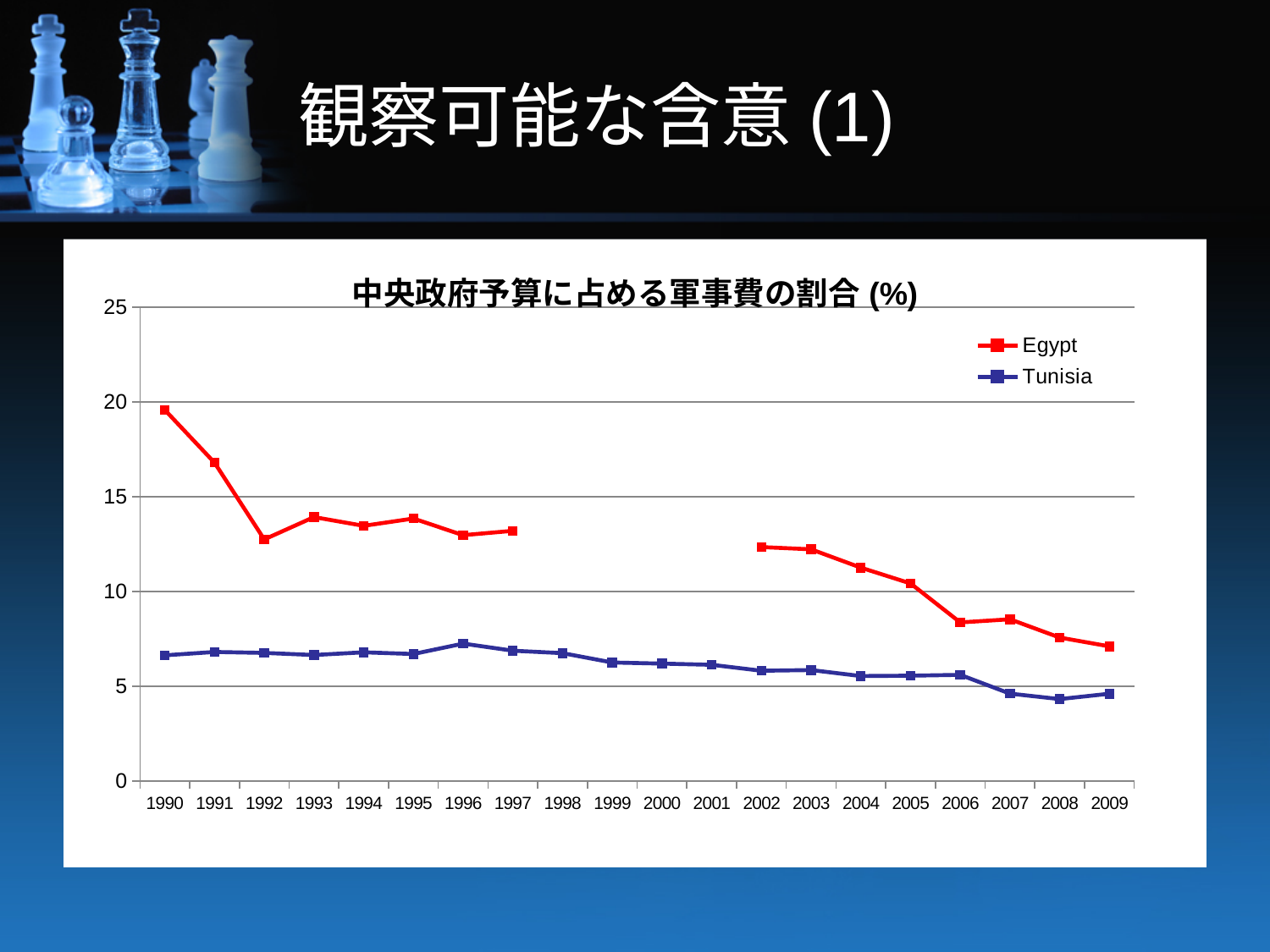
What colour is the line for Egypt? red Does the value for Egypt generally rise or fall from 1990 to 2009? fall Is the value for Egypt in 1990 greater or less than 15? greater How many years are shown along the x axis? 20 Is the value for Tunisia in 2000 greater or less than 5? greater Is the value for Egypt in 2009 greater or less than 10? less What kind of chart is shown on the slide? line chart Which series has the larger value in 2005, Egypt or Tunisia? Egypt How many series does the legend list? 2 In which year is the value for Egypt highest? 1990 Which two series are shown in the legend? Egypt and Tunisia